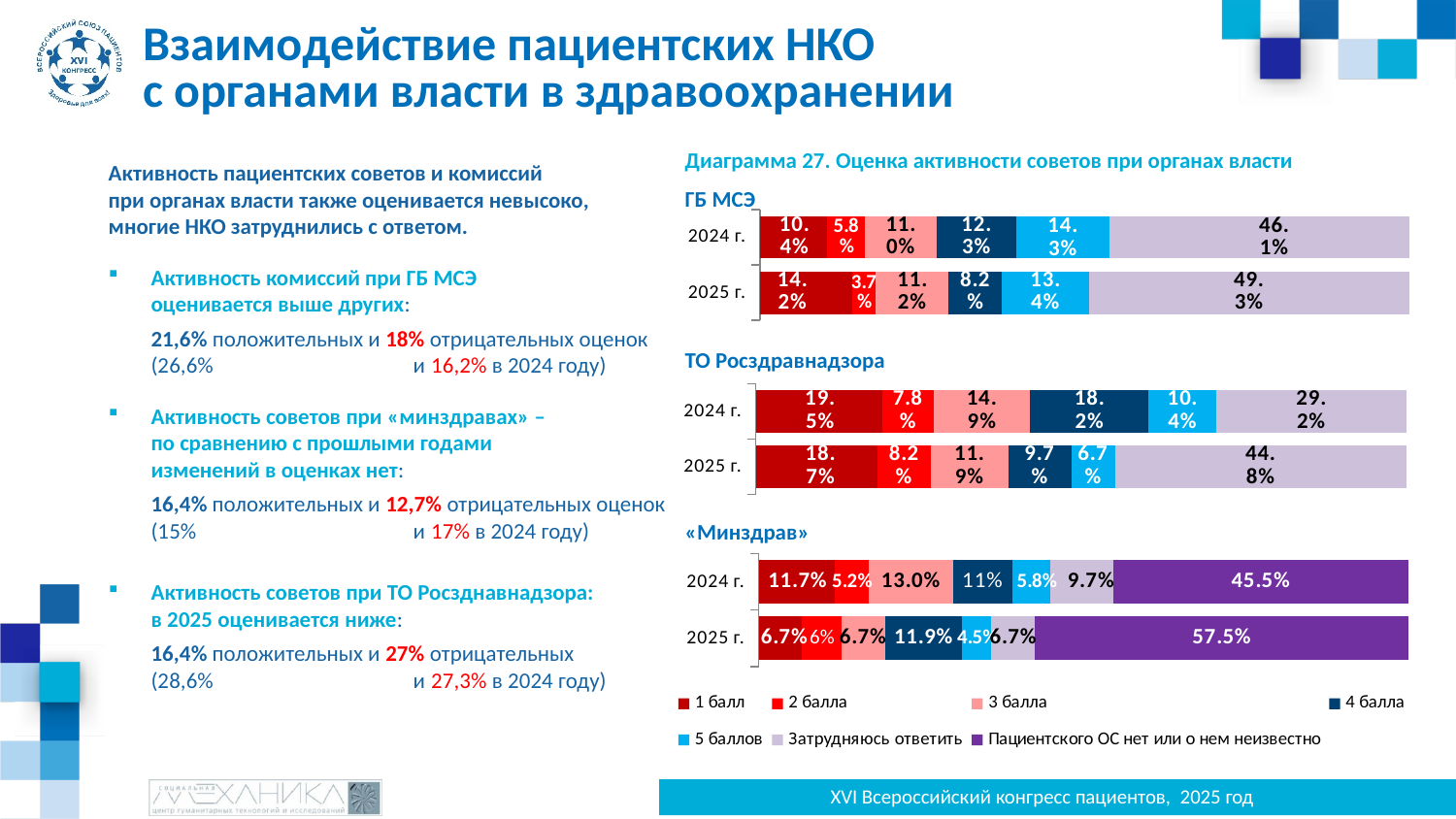
In the ТО Росздравнадзора chart, which segment of the 2025 г. bar is the largest? Затрудняюсь ответить In the ГБ МСЭ chart, what is the value of the «Затрудняюсь ответить» segment for 2025 г.? 49.3% In the ГБ МСЭ chart, what is the value of the «1 балл» segment for 2024 г.? 10.4% What is the title of the diagram on the right side of the slide? Диаграмма 27. Оценка активности советов при органах власти In the «Минздрав» chart, what is the value of the «Пациентского ОС нет или о нем неизвестно» segment for 2025 г.? 57.5% How many series does the legend list? 7 In the «Минздрав» chart, what is the difference between the «Пациентского ОС нет или о нем неизвестно» values for 2025 г. and 2024 г.? 12.0% In the «Минздрав» chart, which segment of the 2024 г. bar is the smallest? 2 балла In the ТО Росздравнадзора chart, what is the value of the «4 балла» segment for 2024 г.? 18.2% In the ТО Росздравнадзора chart, is the «5 баллов» value larger in 2024 г. or in 2025 г.? 2024 г. What kind of chart is used for ГБ МСЭ, ТО Росздравнадзора and «Минздрав»? Stacked bar chart In the ГБ МСЭ chart, what is the difference between the «1 балл» values for 2025 г. and 2024 г.? 3.8%